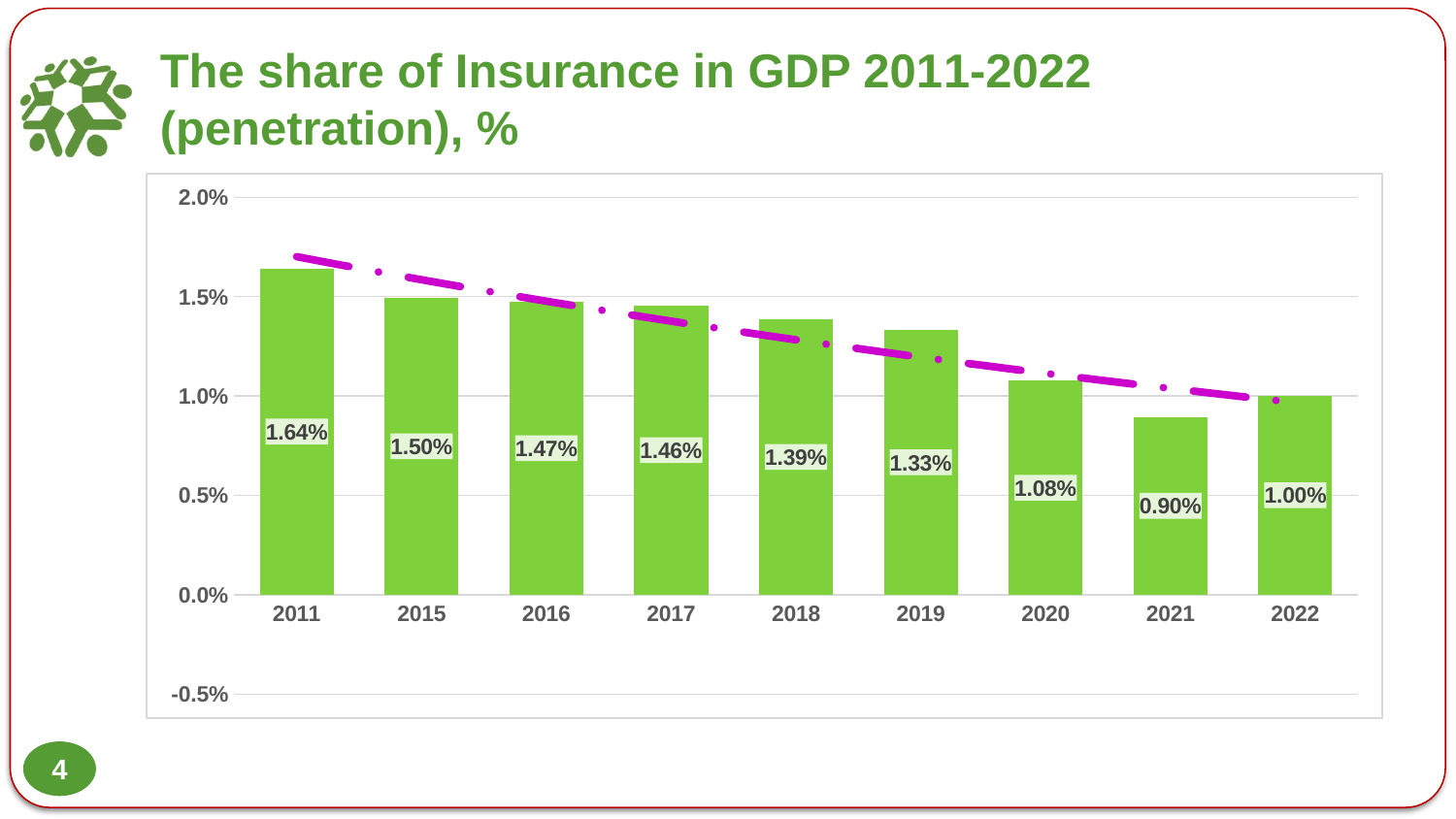
What is the difference between the share of insurance in GDP in 2011 and in 2022? 0.64% What is the share of insurance in GDP for 2011? 1.64% What is the share of insurance in GDP for 2020? 1.08% Which year has a larger share of insurance in GDP, 2018 or 2019? 2018 What is the share of insurance in GDP for 2022? 1.00% Which year has the highest share of insurance in GDP? 2011 What is the title of the chart on the slide? The share of Insurance in GDP 2011-2022 (penetration), % Is the value for 2021 greater or less than 1.0%? less Do the values generally rise or fall from 2011 to 2022? fall How many years are shown on the chart? 9 What kind of chart is shown on the slide? bar chart Which year has the lowest share of insurance in GDP? 2021